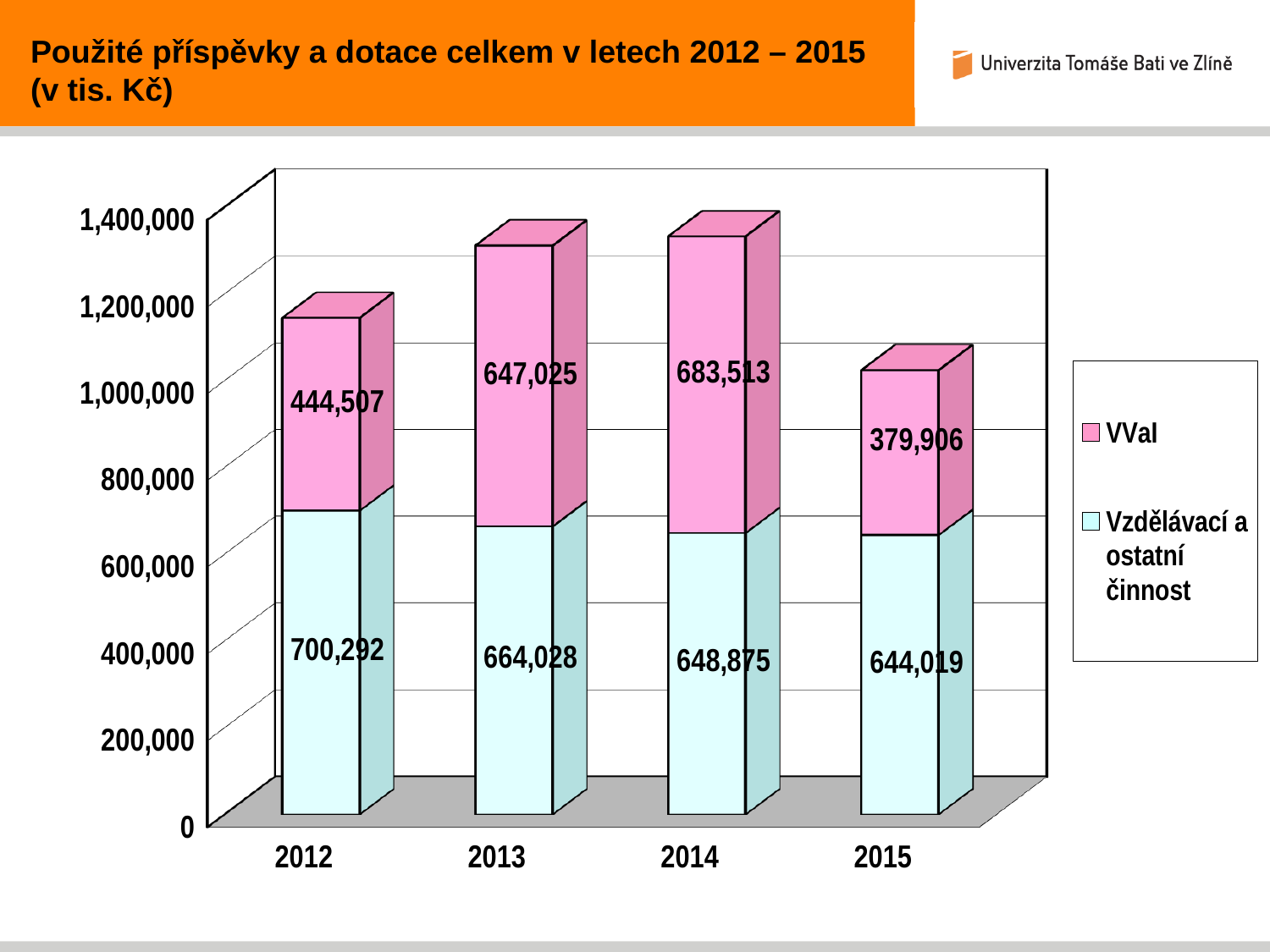
What is the value for VVaI in 2014? 683,513 What is the value for Vzdělávací a ostatní činnost in 2012? 700,292 In which year is the VVaI value the highest? 2014 How many series does the legend list? 2 What kind of chart is shown on the slide? Stacked bar chart What is the total of the stacked bar for 2015? 1,023,925 How many years are shown on the x axis? 4 Which is larger in 2013: VVaI or Vzdělávací a ostatní činnost? Vzdělávací a ostatní činnost What is the difference between the VVaI values for 2014 and 2015? 303,607 What is the total of the stacked bar for 2013? 1,311,053 What is the value for VVaI in 2015? 379,906 In which year is the VVaI value the lowest? 2015